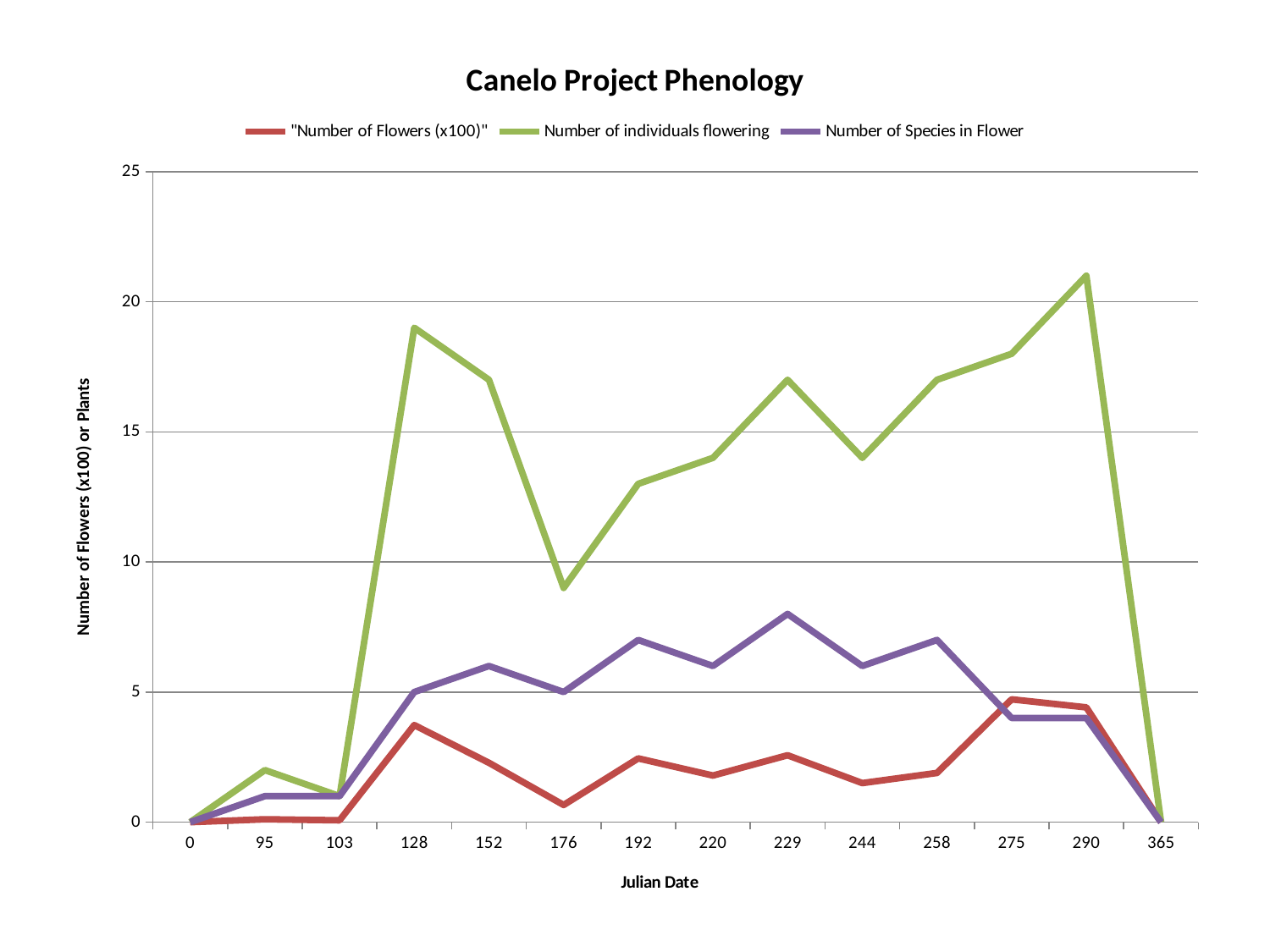
At which Julian Date does the Number of individuals flowering reach its highest value? 290 Is the Number of individuals flowering at Julian Date 128 greater or less than 15? greater What is the title of the chart? Canelo Project Phenology What kind of chart is shown on the slide? line chart Is the Number of Species in Flower at Julian Date 229 greater or less than 5? greater Is the Number of individuals flowering at Julian Date 290 greater or less than 20? greater How many Julian Date points are plotted along the x axis? 14 How many series does the legend list? 3 At Julian Date 220, which is larger: Number of individuals flowering or Number of Species in Flower? Number of individuals flowering What is the Number of Species in Flower at Julian Date 128? 5 What is the Number of individuals flowering at Julian Date 365? 0